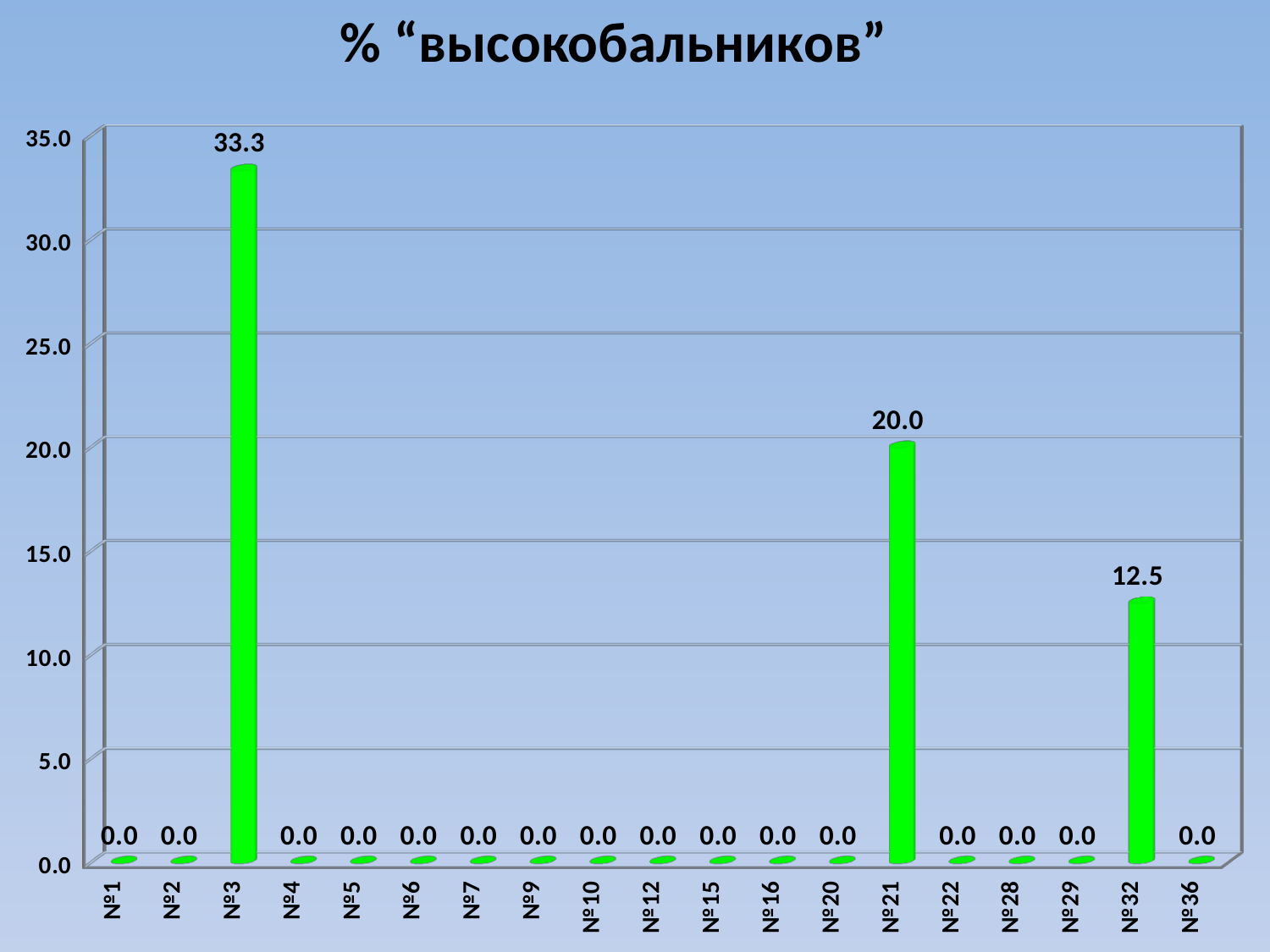
What is the value for №32? 12.5 What is the difference between the values for №21 and №32? 7.5 What kind of chart is shown on the slide? bar chart What is the difference between the values for №3 and №21? 13.3 Is the value for №3 greater or less than 30.0? greater Which category has the highest value? №3 Which is larger, the value for №21 or the value for №32? №21 How many categories are shown on the x axis? 19 What is the title of the chart? % "высокобальников" What is the value for №3? 33.3 What is the value for №15? 0.0 What is the value for №21? 20.0